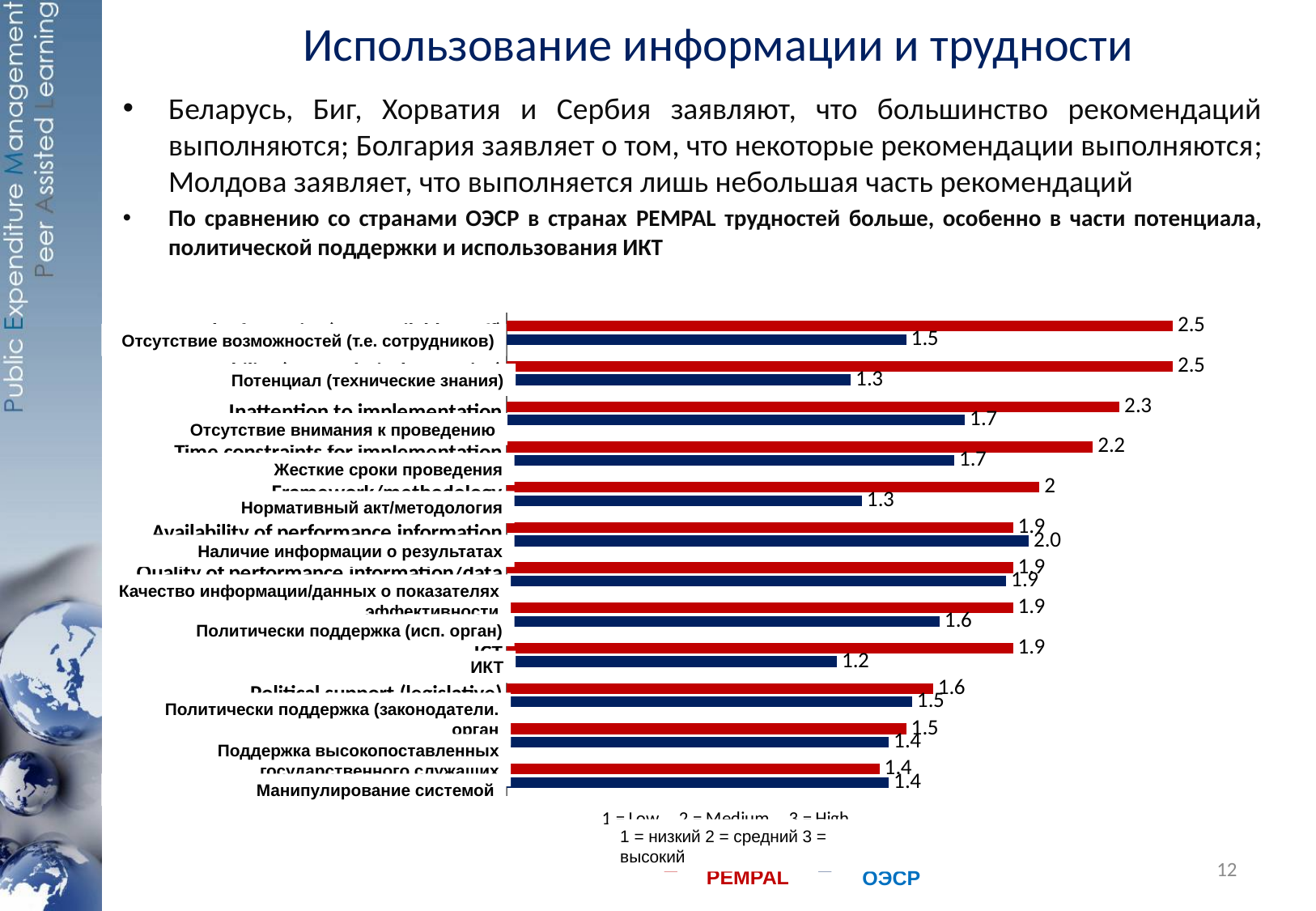
For Жесткие сроки проведения, which series has the larger value, PEMPAL or ОЭСР? PEMPAL How many categories are plotted in the chart? 12 Which category has the highest ОЭСР value? Наличие информации о результатах What are the two series named in the chart legend? PEMPAL and ОЭСР Which category has the lowest ОЭСР value? ИКТ What is the PEMPAL value for Нормативный акт/методология? 2 What type of chart is shown on the slide? bar chart Which category has the lowest PEMPAL value? Манипулирование системой What is the ОЭСР value for ИКТ? 1.2 What is the PEMPAL value for Потенциал (технические знания)? 2.5 What is the difference between the PEMPAL and ОЭСР values for Отсутствие возможностей (т.е. сотрудников)? 1.0 How many series does the chart legend list? 2